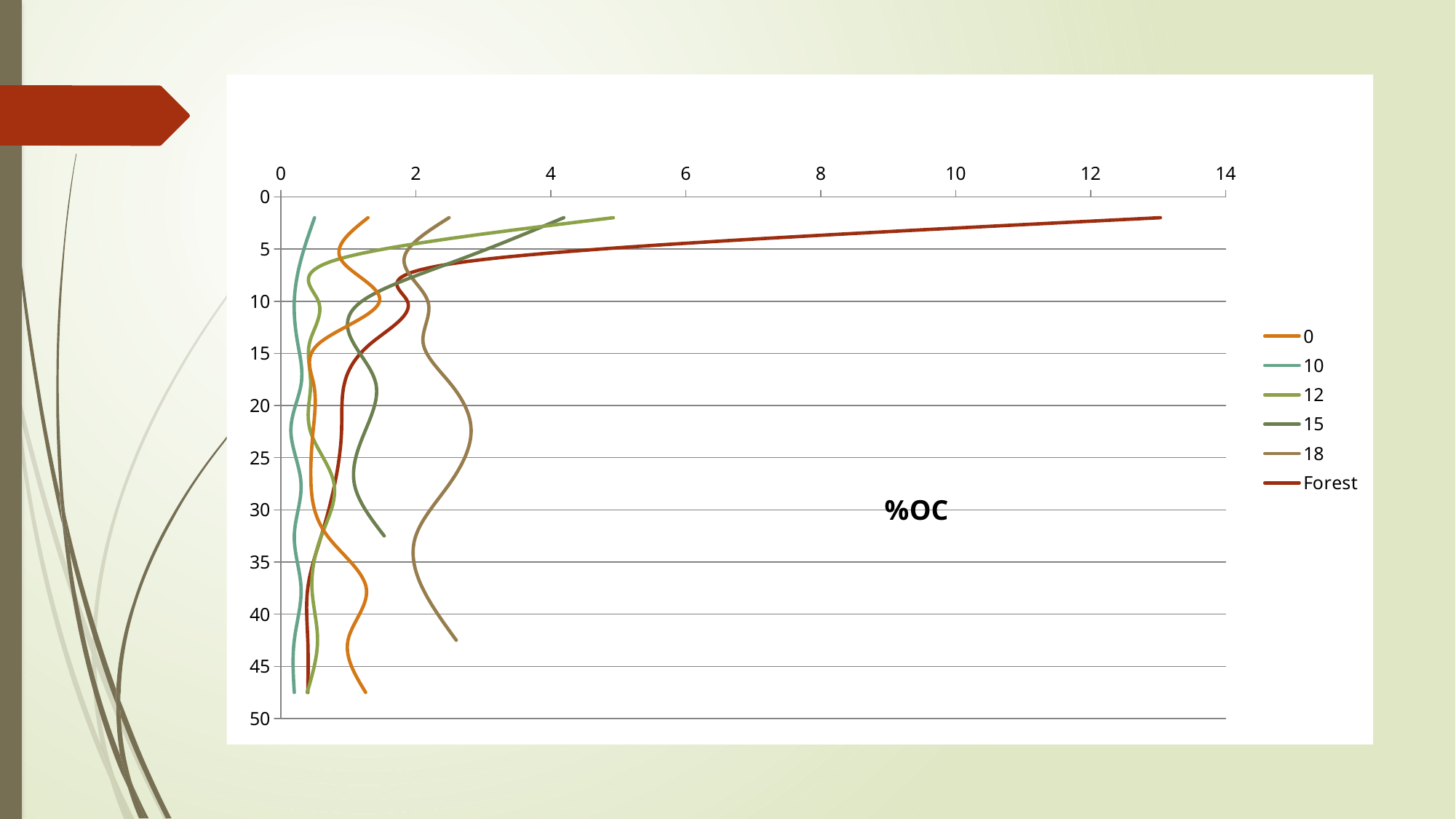
Is the highest value of the series 10 greater or less than 1? less At the shallowest depth plotted, which series has the larger value, Forest or 0? Forest What kind of chart is shown on the slide? line chart What text label is printed inside the plot area of the chart? %OC What are the series names listed in the legend? 0, 10, 12, 15, 18, Forest Which series reaches the highest value on the horizontal axis? Forest Is the highest value of the series 12 greater or less than 4? greater Which series stays at the lowest values across all depths? 10 Does the Forest series value rise or fall as depth increases from about 2 to about 10? fall How many series does the legend list? 6 Is the highest value of the series 18 greater or less than 2? greater